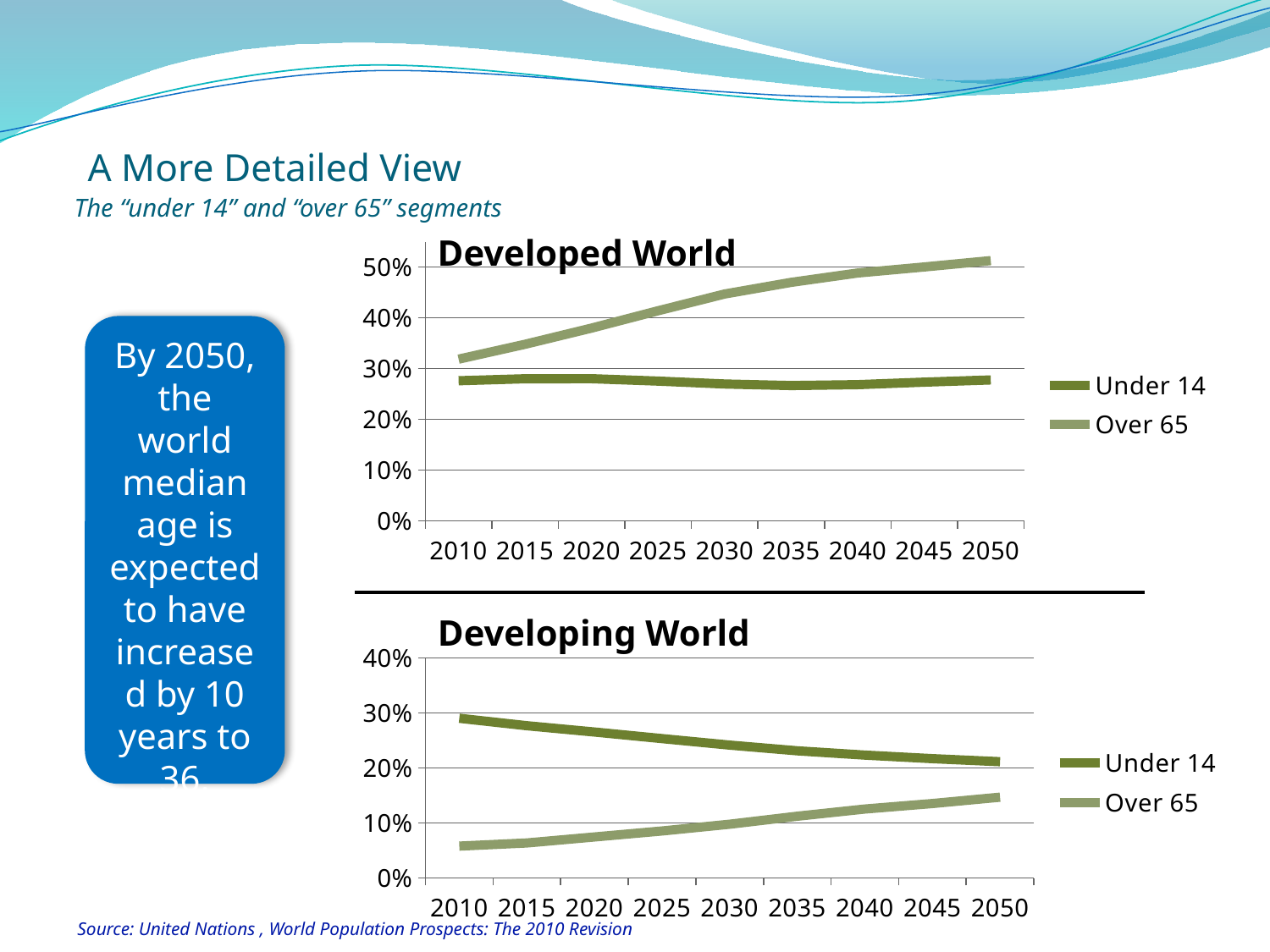
In the Developing World chart, is the Over 65 value in 2050 greater or less than 10%? greater How many series does the legend of the Developing World chart list? 2 In the Developed World chart, which series has the larger value in 2050, Under 14 or Over 65? Over 65 In the Developing World chart, does the Under 14 line rise or fall from 2010 to 2050? fall In the Developing World chart, does the Over 65 line rise or fall from 2010 to 2050? rise In the Developed World chart, is the Over 65 value in 2030 greater or less than 40%? greater In the Developed World chart, does the Over 65 line rise or fall from 2010 to 2050? rise In the Developing World chart, which series has the larger value in 2010, Under 14 or Over 65? Under 14 What type of chart is the Developed World chart? line chart In the Developing World chart, is the Over 65 value in 2010 greater or less than 10%? less How many years are shown on the x axis of the Developed World chart? 9